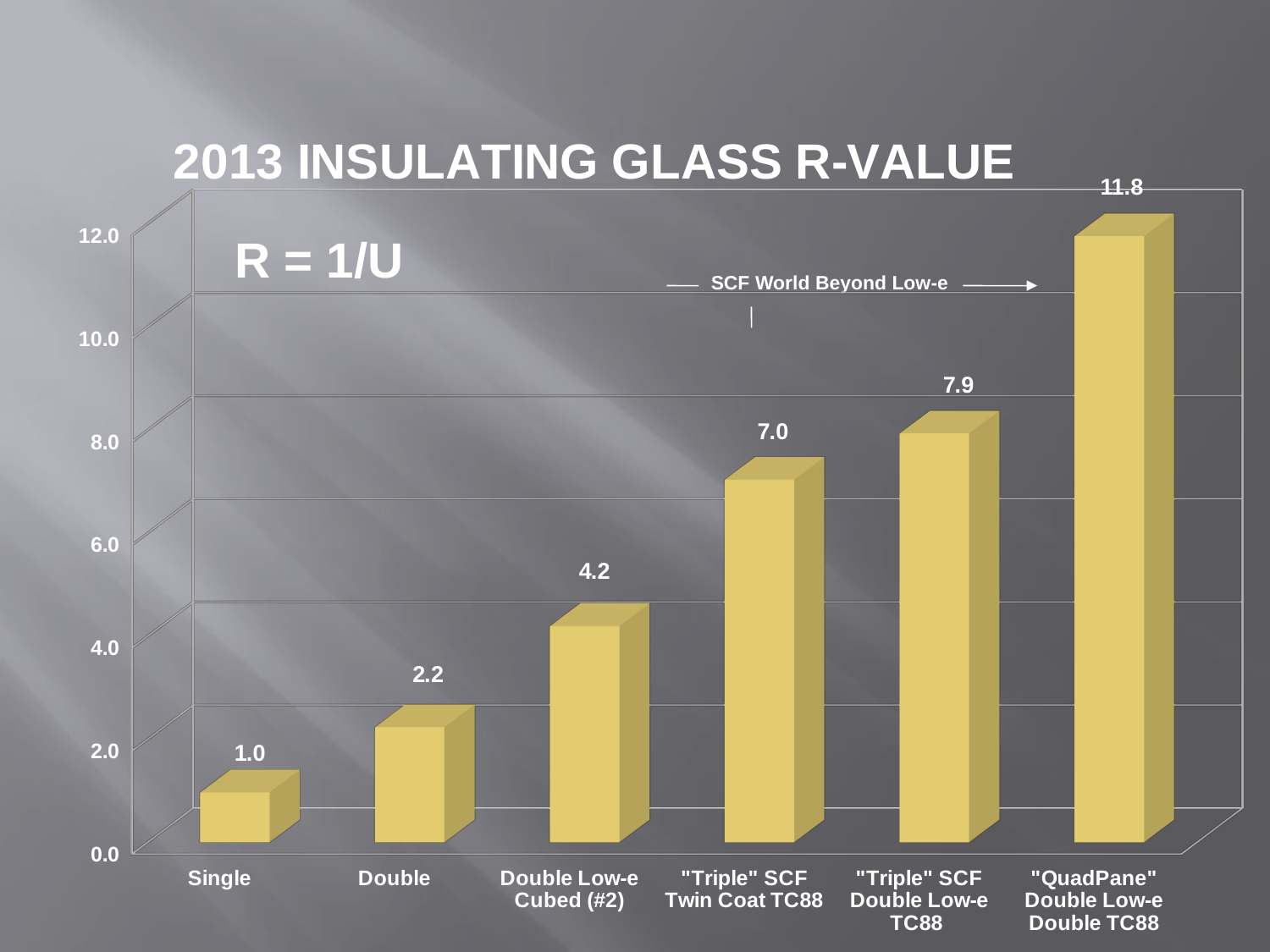
What is the R-value shown for "QuadPane" Double Low-e Double TC88? 11.8 What kind of chart is shown on the slide? Bar chart How many glass types are shown on the chart? 6 What is the difference in R-value between Double Low-e Cubed (#2) and Double? 2.0 Do the R-values rise or fall from left to right across the glass types? Rise What is the difference in R-value between "QuadPane" Double Low-e Double TC88 and "Triple" SCF Double Low-e TC88? 3.9 What is the title of the chart? 2013 INSULATING GLASS R-VALUE What is the R-value shown for "Triple" SCF Twin Coat TC88? 7.0 What is the R-value shown for Single glass? 1.0 Which has a higher R-value, "Triple" SCF Double Low-e TC88 or "Triple" SCF Twin Coat TC88? "Triple" SCF Double Low-e TC88 Which glass type has the lowest R-value? Single Which glass type has the highest R-value? "QuadPane" Double Low-e Double TC88